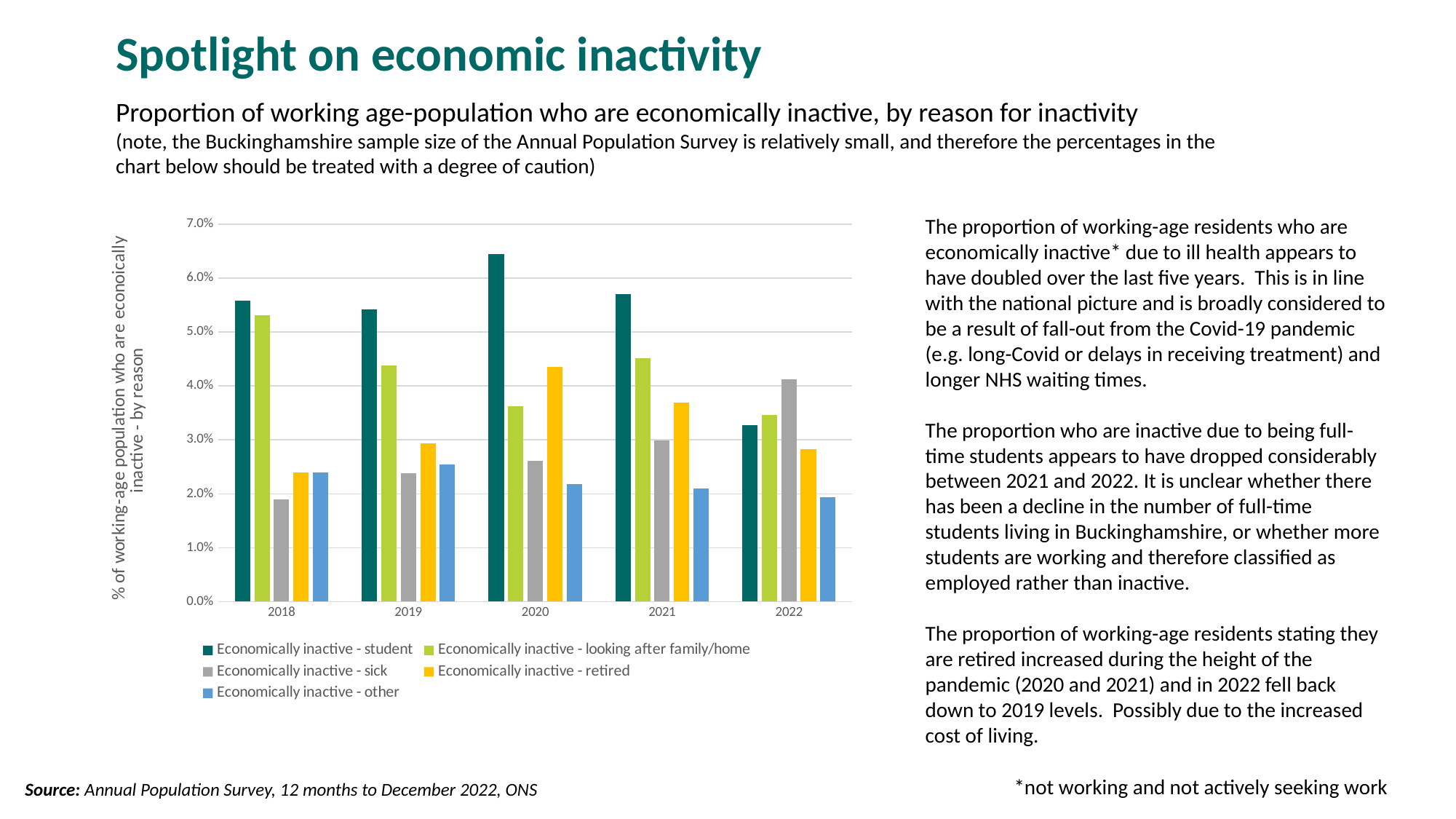
In which year is the 'Economically inactive - student' bar highest? 2020 Is the value for 'Economically inactive - looking after family/home' in 2019 greater or less than 4.0%? greater What kind of chart is shown on the slide? Bar chart In 2018, which is larger: 'Economically inactive - student' or 'Economically inactive - looking after family/home'? Economically inactive - student What is the highest tick value shown on the chart's y axis? 7.0% Does the 'Economically inactive - sick' series rise or fall from 2018 to 2022? Rises Is the value for 'Economically inactive - sick' in 2018 greater or less than 2.0%? less Is the value for 'Economically inactive - student' in 2020 greater or less than 6.0%? greater How many series does the chart's legend list? 5 How many years are shown along the x axis of the chart? 5 In 2022, which is larger: 'Economically inactive - sick' or 'Economically inactive - student'? Economically inactive - sick